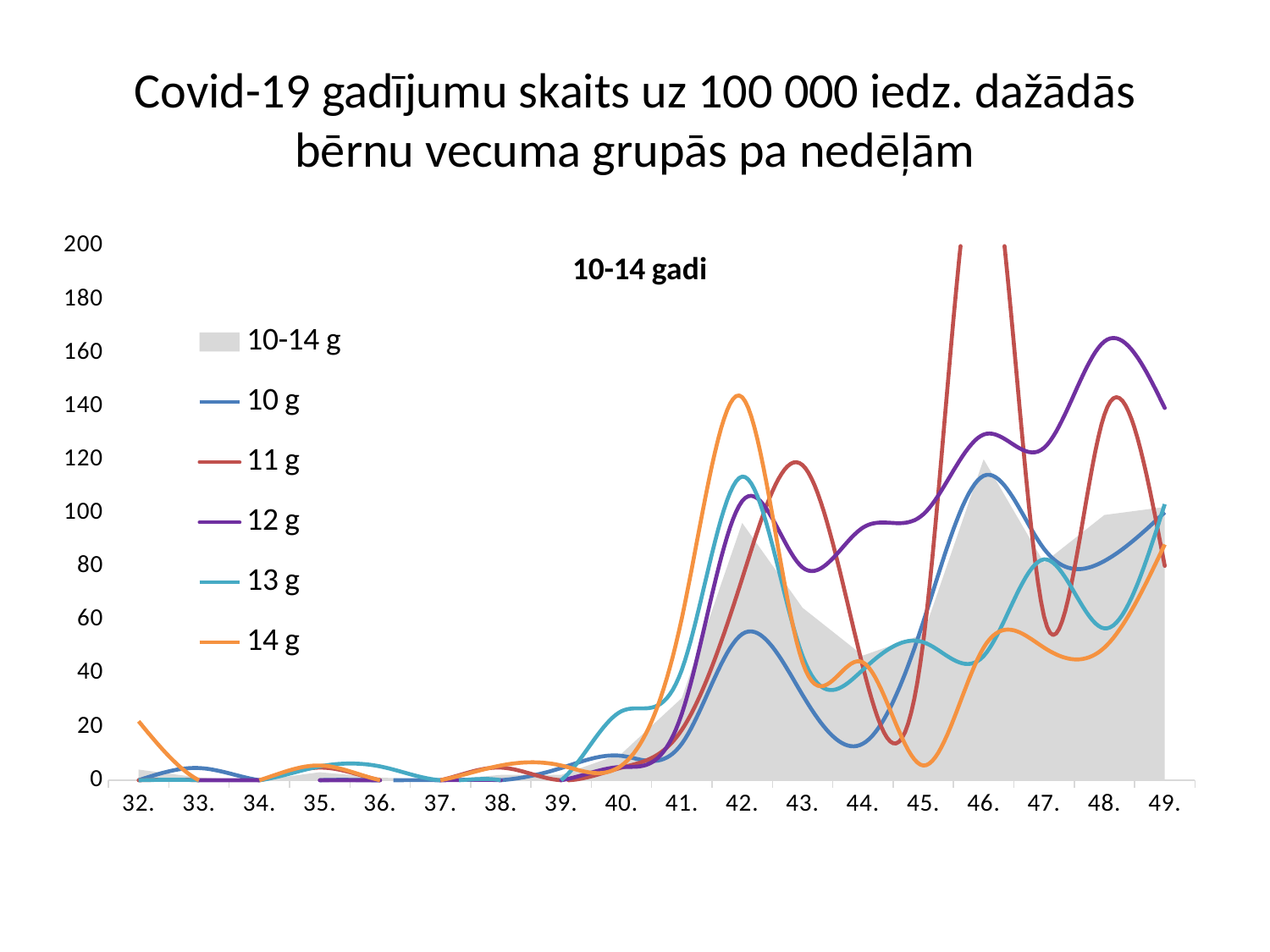
How many series does the legend list? 6 Is the value for 12 g at week 48. greater or less than 140? greater Is the value for 14 g at week 42. greater or less than 120? greater Which legend entry is drawn as a shaded grey area rather than a line? 10-14 g Is the value for 14 g at week 45. greater or less than 20? less How many weeks are shown along the x axis? 18 What is the title of the slide? Covid-19 gadījumu skaits uz 100 000 iedz. dažādās bērnu vecuma grupās pa nedēļām Which series has the highest value at week 48.? 12 g At week 42., which is larger: the value for 14 g or the value for 10 g? 14 g What kind of chart is shown on the slide? combination area and line chart Does the 10-14 g area rise or fall from week 44. to week 46.? rise